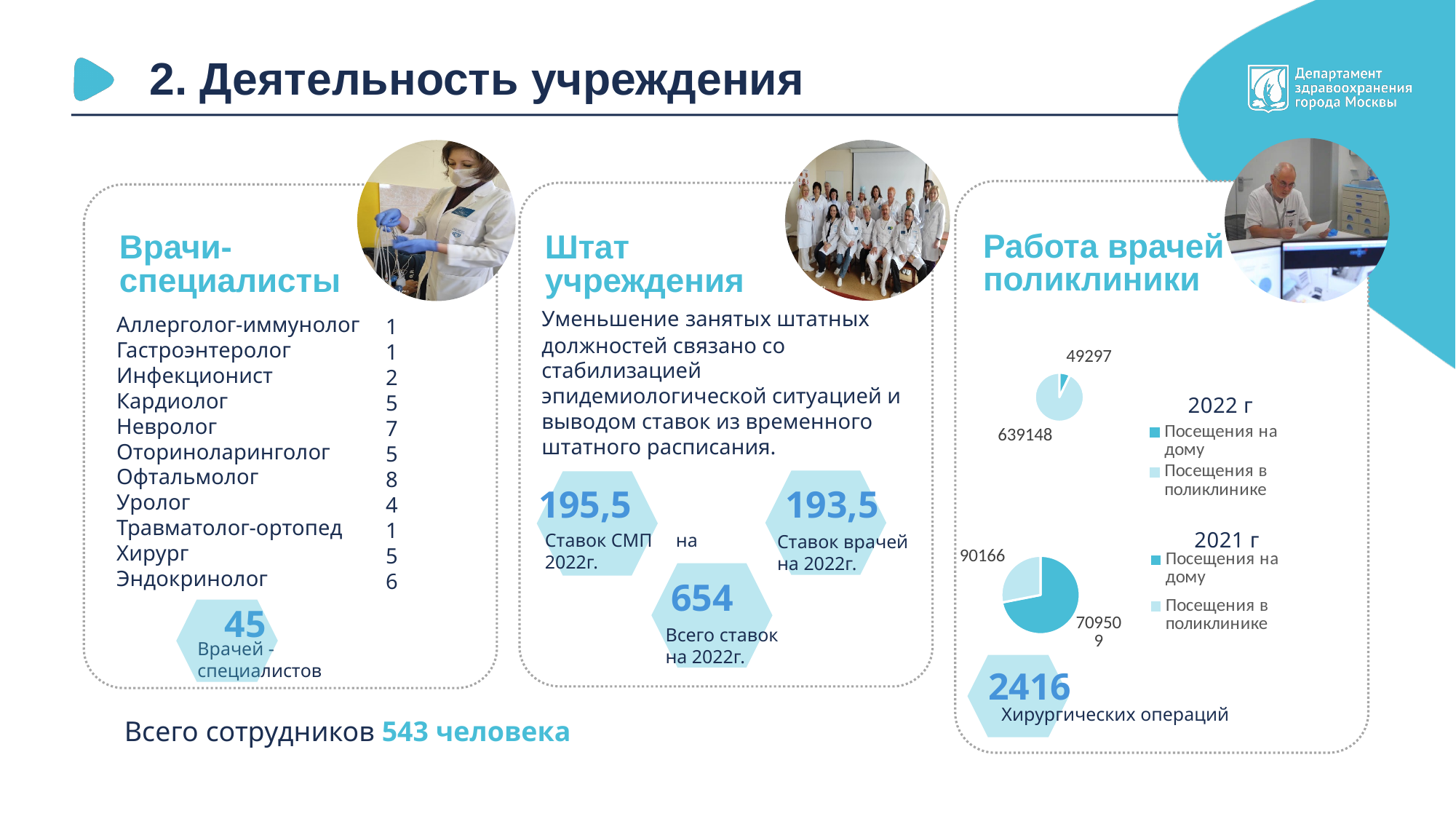
In the 2022 г pie chart, what is the difference between 'Посещения в поликлинике' and 'Посещения на дому'? 589851 What is the total of the two values shown in the 2022 г pie chart? 688445 What kind of chart is used for the 2022 г visits data in the 'Работа врачей поликлиники' section? pie chart In the 2022 г pie chart, what is the value for 'Посещения в поликлинике'? 639148 In the 2022 г pie chart, which category has the largest slice? Посещения в поликлинике In the 2022 г pie chart, what is the value for 'Посещения на дому'? 49297 How many categories does the legend of the 2022 г pie chart list? 2 In the 2021 г pie chart, what is the value of the smallest slice? 90166 In the 2022 г pie chart, which is larger: 'Посещения на дому' or 'Посещения в поликлинике'? Посещения в поликлинике In the 2022 г pie chart, which category has the smallest slice? Посещения на дому What is the total of the two values shown in the 2021 г pie chart? 799675 In the 2021 г pie chart, what is the value of the largest slice? 709509